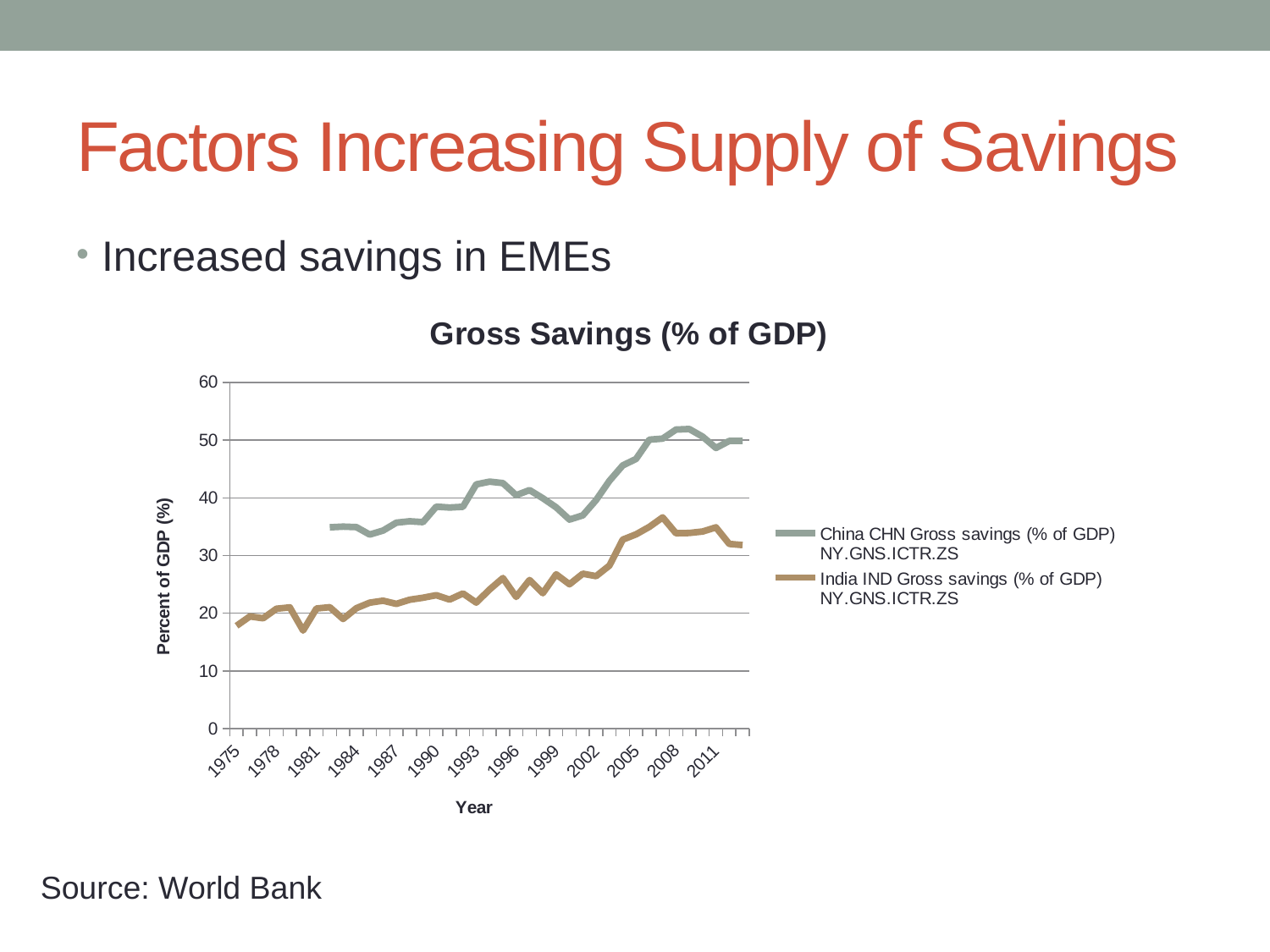
Is the value for India in 2008 greater or less than 30? greater Does India's gross savings (% of GDP) generally rise or fall from 1975 to 2008? rise What kind of chart is shown on the slide? Line chart Which of the two countries has the higher gross savings (% of GDP) throughout the period shown? China Which series has the higher gross savings in 2005, China or India? China How many series does the chart's legend list? 2 Is the value for China in 2005 greater or less than 40? greater Is the value for China in 1984 greater or less than 40? less Does China's gross savings (% of GDP) rise or fall from 2002 to 2008? rise What is the label on the vertical axis of the chart? Percent of GDP (%) What is the title of the chart? Gross Savings (% of GDP)